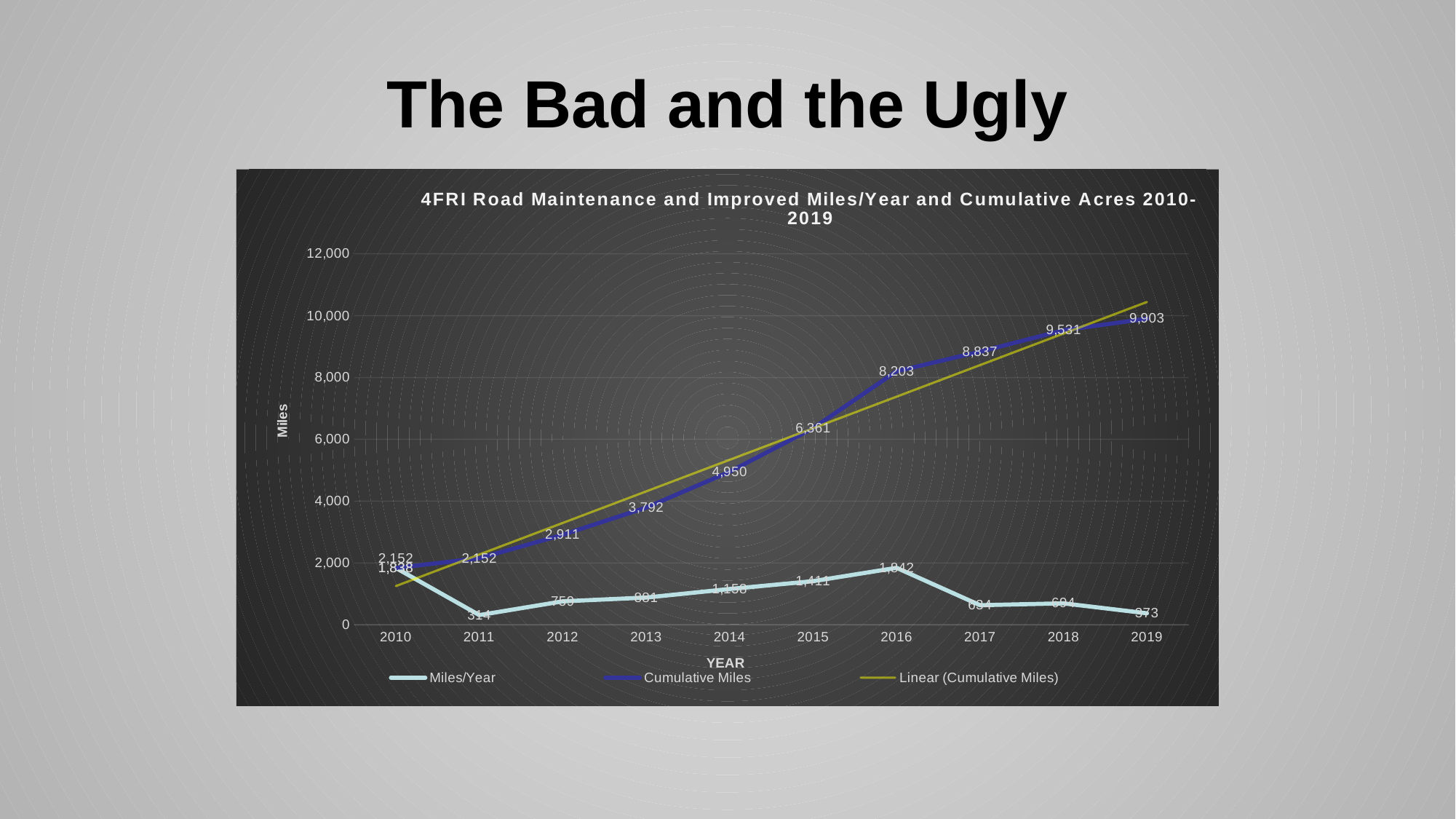
What is the Miles/Year value for 2011? 314 What kind of chart is shown on the slide? line chart How many series does the legend list? 3 Is the Cumulative Miles value for 2017 greater or less than 8,000? greater In which year is Miles/Year lowest? 2011 What is the difference between Cumulative Miles in 2016 and in 2015? 1,842 Which year has the larger Cumulative Miles value, 2013 or 2014? 2014 How many years are plotted along the x axis? 10 What is the label on the vertical axis? Miles In which year is Cumulative Miles highest? 2019 What is the Cumulative Miles value for 2015? 6,361 What is the Cumulative Miles value for 2019? 9,903